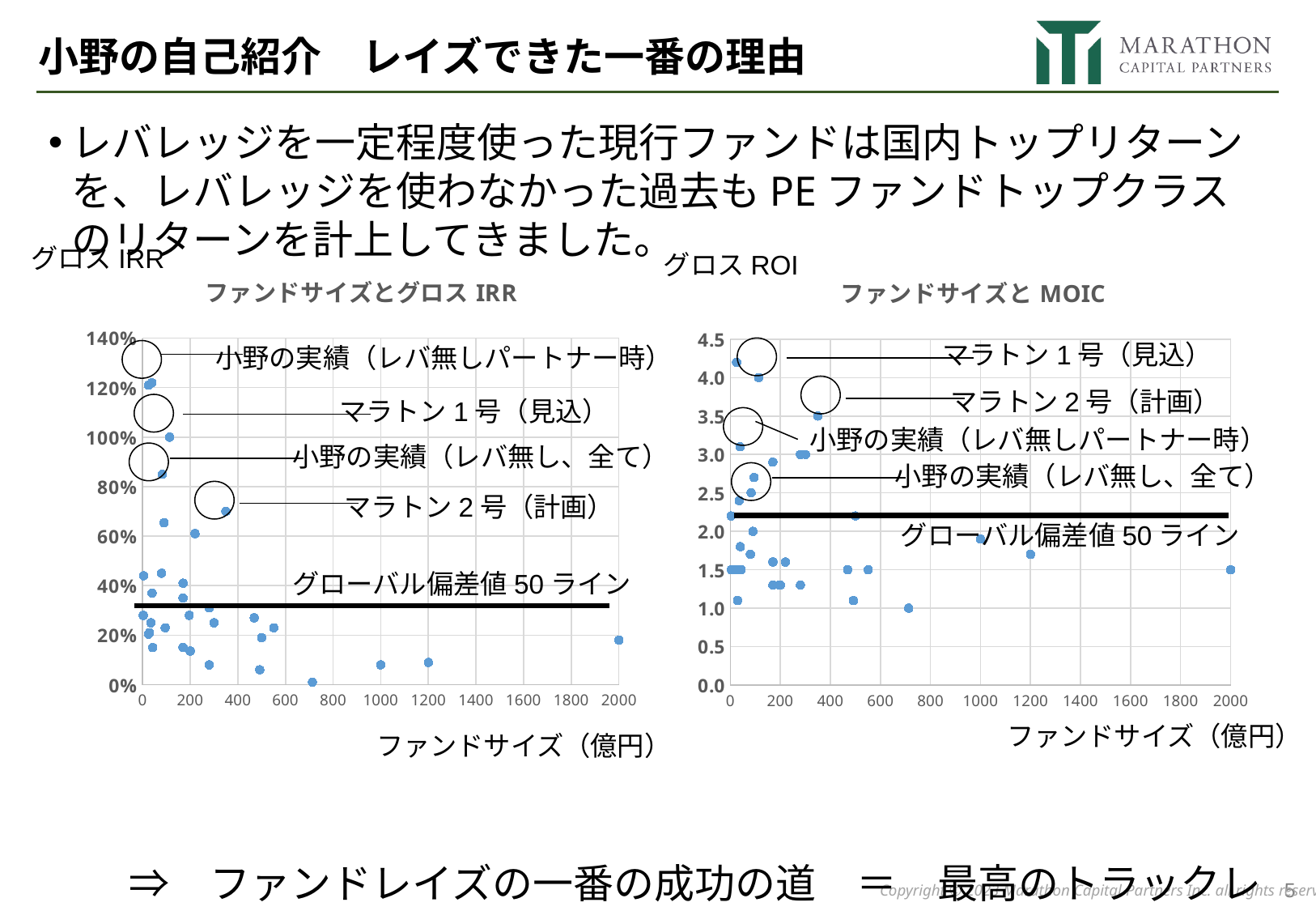
In the left chart titled ファンドサイズとグロス IRR, which is larger: the value for マラトン1号（見込） or the value for マラトン2号（計画）? マラトン1号（見込） In the left chart titled ファンドサイズとグロス IRR, is the value for マラトン2号（計画） greater or less than 60%? greater What kind of chart is the right chart titled ファンドサイズと MOIC? scatter chart In the right chart titled ファンドサイズと MOIC, is the グローバル偏差値50ライン greater or less than 2.0? greater In the left chart titled ファンドサイズとグロス IRR, is the value for 小野の実績（レバ無しパートナー時） greater or less than 100%? greater What kind of chart is the left chart titled ファンドサイズとグロス IRR? scatter chart What is the title of the right chart? ファンドサイズと MOIC What is the x-axis label of the left chart titled ファンドサイズとグロス IRR? ファンドサイズ（億円）